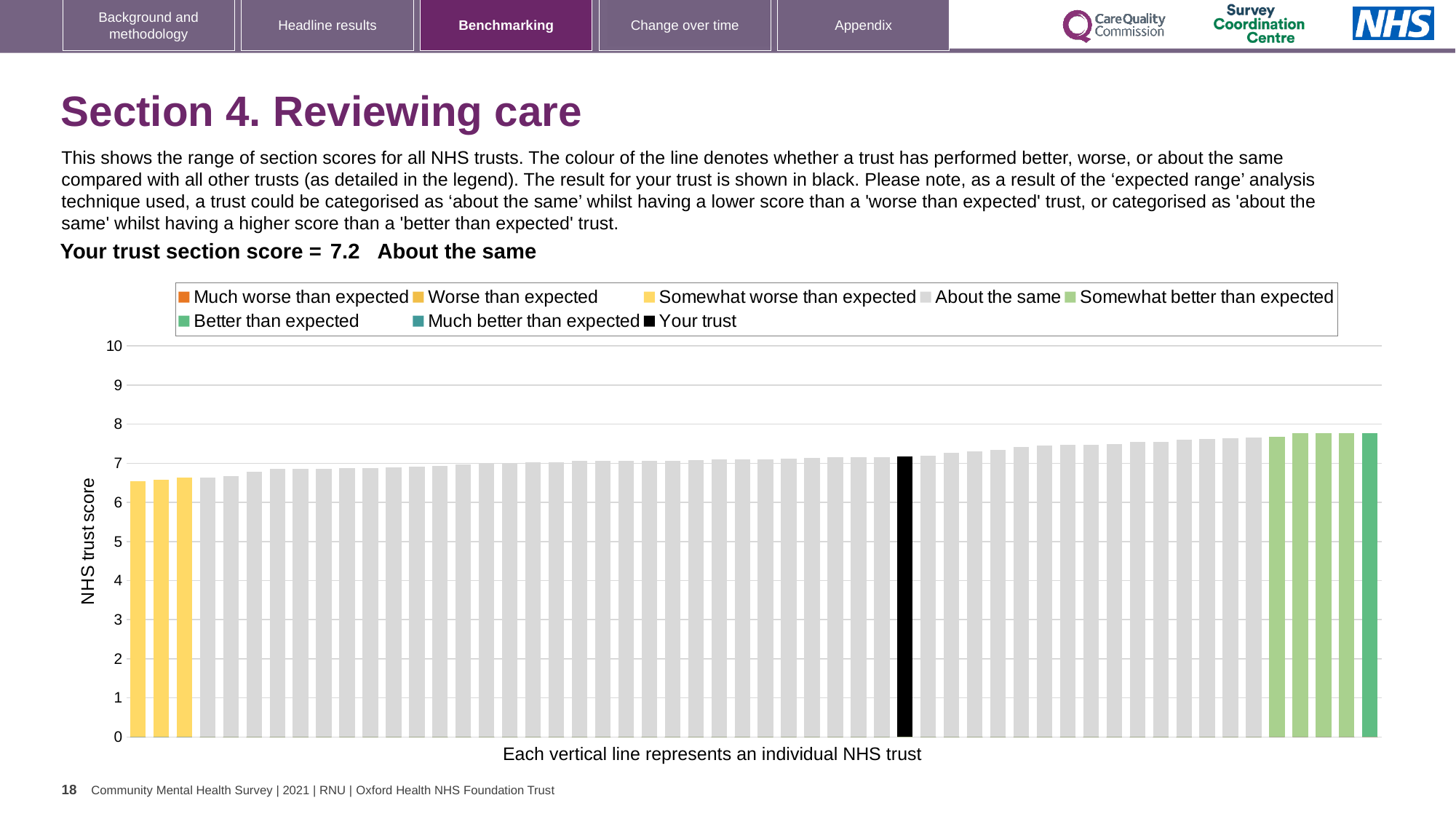
Is the value of the lowest bar in the chart greater or less than 7? less What is the section score for your trust shown on the slide? 7.2 Is the value for your trust (the black bar) greater or less than 7? greater Which performance category is your trust placed in for this section? About the same What is the label on the y axis of the chart? NHS trust score How many entries does the chart legend list? 8 Is the value of the highest bar in the chart greater or less than 8? less How many bars are coloured as 'Somewhat better than expected' (light green)? 4 Do the bar values rise or fall from left to right along the x axis? rise What type of chart is shown on the slide? bar chart